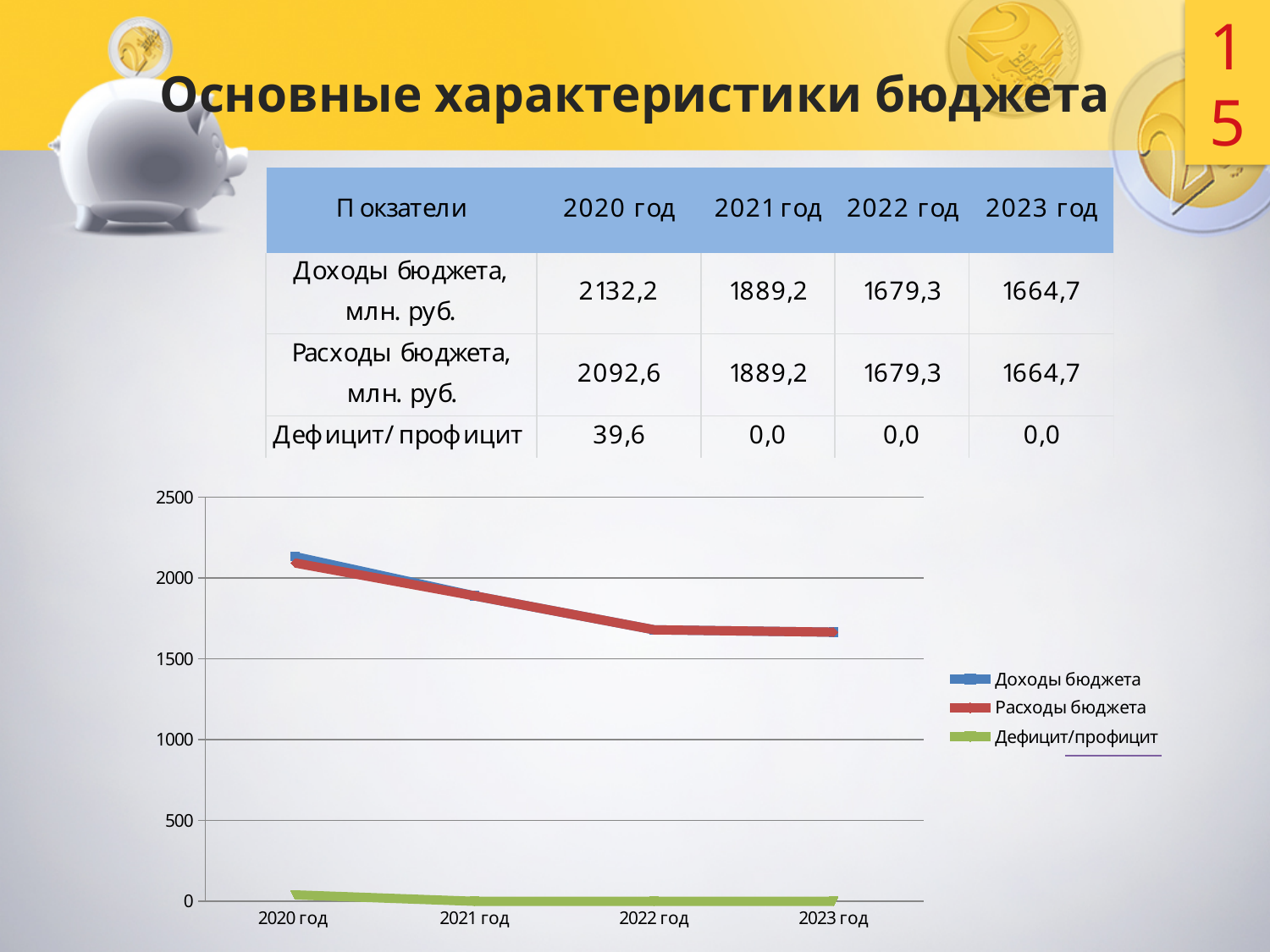
What is the value of Расходы бюджета for 2020 год? 2092,6 How many years are shown along the x axis of the chart? 4 Is the value of Расходы бюджета for 2022 год greater or less than 2000? less What is the value of Дефицит/профицит for 2020 год? 39,6 What is the difference between Доходы бюджета and Расходы бюджета in 2020 год? 39,6 What is the value of Расходы бюджета for 2023 год? 1664,7 In which year is Доходы бюджета highest? 2020 год Does the Доходы бюджета line rise or fall from 2020 год to 2023 год? falls What is the value of Доходы бюджета for 2020 год? 2132,2 How many series does the chart legend list? 3 What kind of chart is shown on the slide? line chart Which colour is used for the Дефицит/профицит series in the chart? green